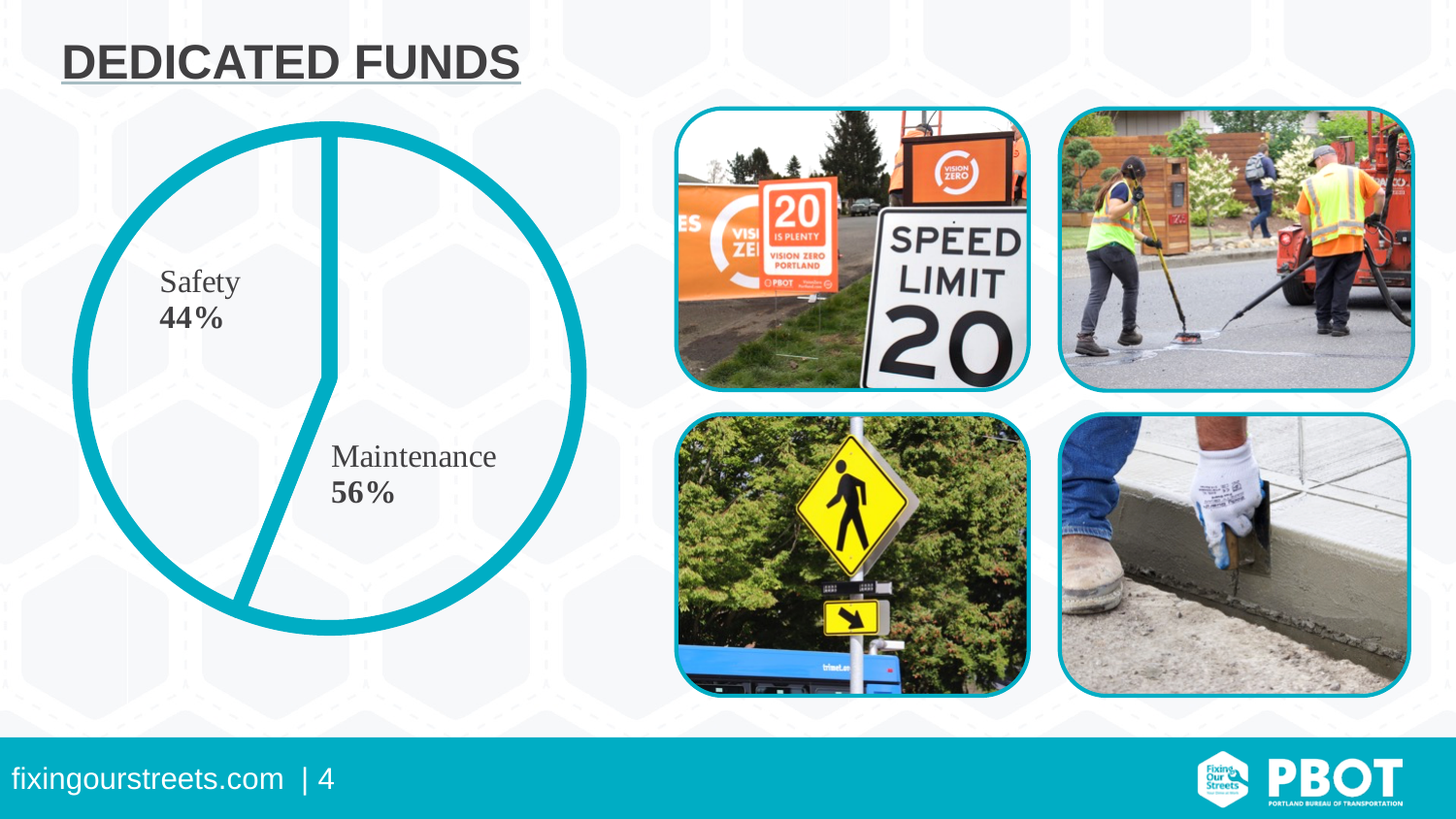
What share of dedicated funds goes to Maintenance? 56% How many slices does the pie chart have? 2 What share of dedicated funds goes to Safety? 44% Which category receives the largest share of dedicated funds? Maintenance What kind of chart is shown on the slide? pie chart What is the difference in percentage points between the Maintenance share and the Safety share? 12 percentage points What is the title of the slide containing the pie chart? DEDICATED FUNDS Is the Safety share greater or less than 50%? less Which category receives the smallest share of dedicated funds? Safety What do the two slices of the pie chart add up to? 100% Is the Maintenance share greater or less than 50%? greater Which is larger, the Safety share or the Maintenance share? Maintenance